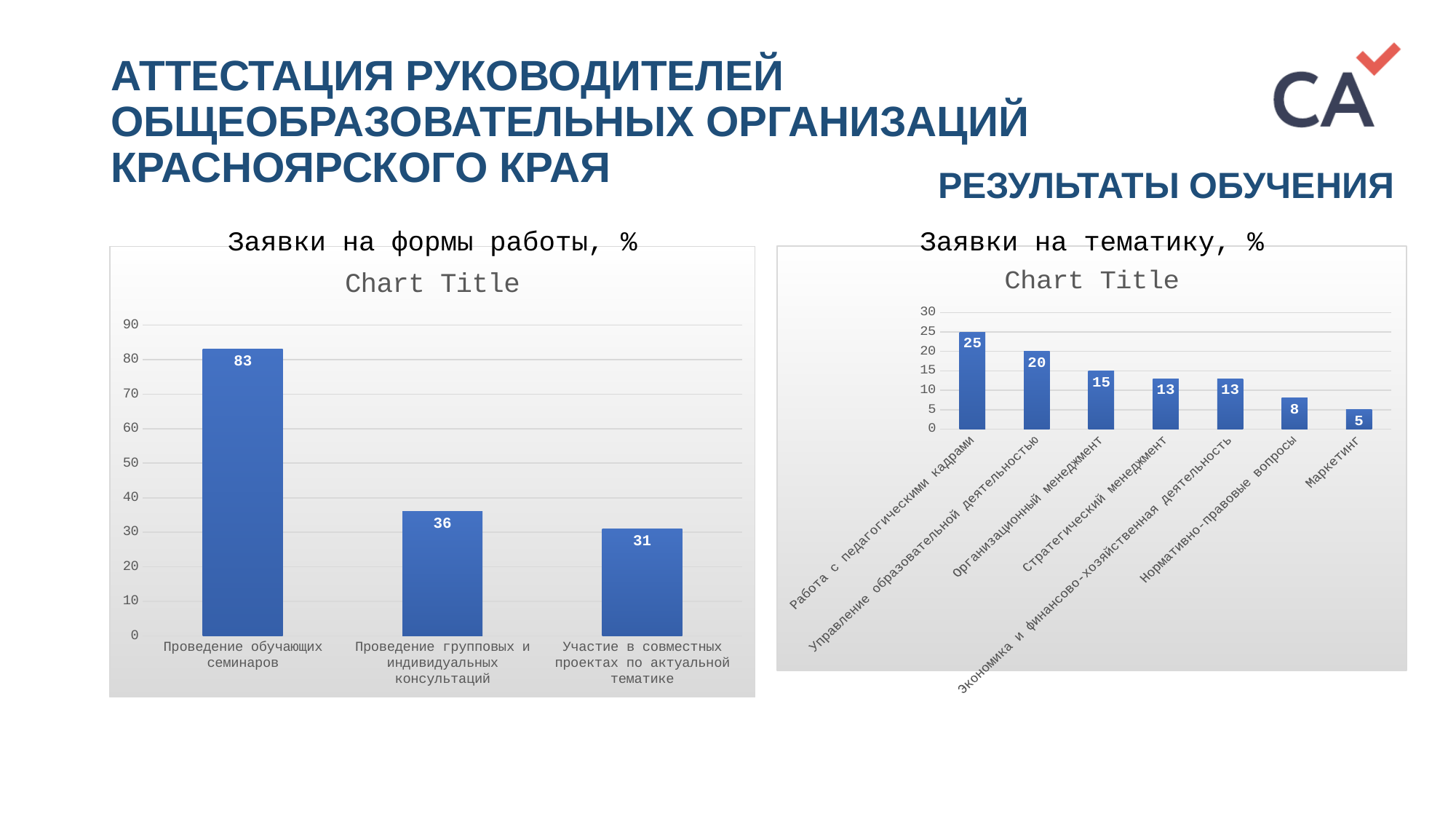
In the left chart 'Заявки на формы работы, %', what is the value for 'Участие в совместных проектах по актуальной тематике'? 31 In the left chart 'Заявки на формы работы, %', what is the difference between 'Проведение обучающих семинаров' and 'Проведение групповых и индивидуальных консультаций'? 47 In the right chart 'Заявки на тематику, %', how many categories are shown? 7 In the right chart 'Заявки на тематику, %', what is the value for 'Маркетинг'? 5 In the left chart 'Заявки на формы работы, %', what is the value for 'Проведение обучающих семинаров'? 83 In the left chart 'Заявки на формы работы, %', how many categories are shown? 3 In the right chart 'Заявки на тематику, %', which category has the lowest value? Маркетинг In the right chart 'Заявки на тематику, %', do the values rise or fall from left to right? fall In the left chart 'Заявки на формы работы, %', which category has the highest value? Проведение обучающих семинаров In the right chart 'Заявки на тематику, %', what is the value for 'Организационный менеджмент'? 15 In the right chart 'Заявки на тематику, %', which is larger: 'Управление образовательной деятельностью' or 'Нормативно-правовые вопросы'? Управление образовательной деятельностью What type of chart is the left chart 'Заявки на формы работы, %'? bar chart